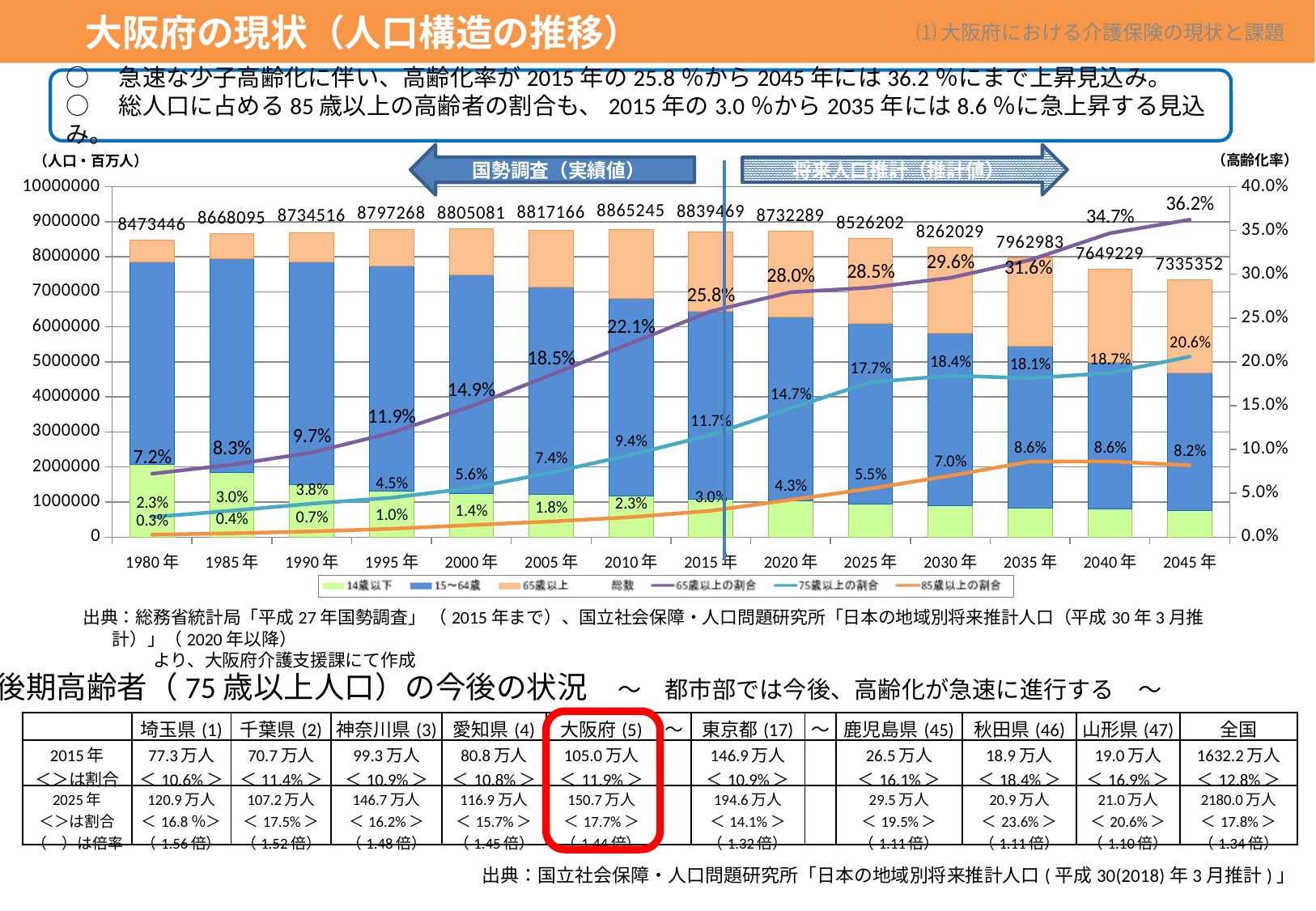
What is the 75歳以上の割合 value shown for 2020年? 14.7% How many years are shown on the x axis of the chart? 14 What is the 65歳以上の割合 value shown for 2045年? 36.2% How many series does the chart legend list? 7 What is the total population (総数) shown for 2010年? 8865245 In which year is the total population (総数) label the lowest? 2045年 What is the 85歳以上の割合 value shown for 2035年? 8.6% Which is larger, the total population (総数) for 1980年 or for 2040年? 1980年 In which year is the total population (総数) label the highest? 2010年 What is the difference between the 65歳以上の割合 values for 2045年 and 2015年? 10.4% Is the 15～64歳 bar segment for 2045年 greater or less than 5000000 on the left axis? less Does the 65歳以上の割合 line rise or fall from 1980年 to 2045年? rise